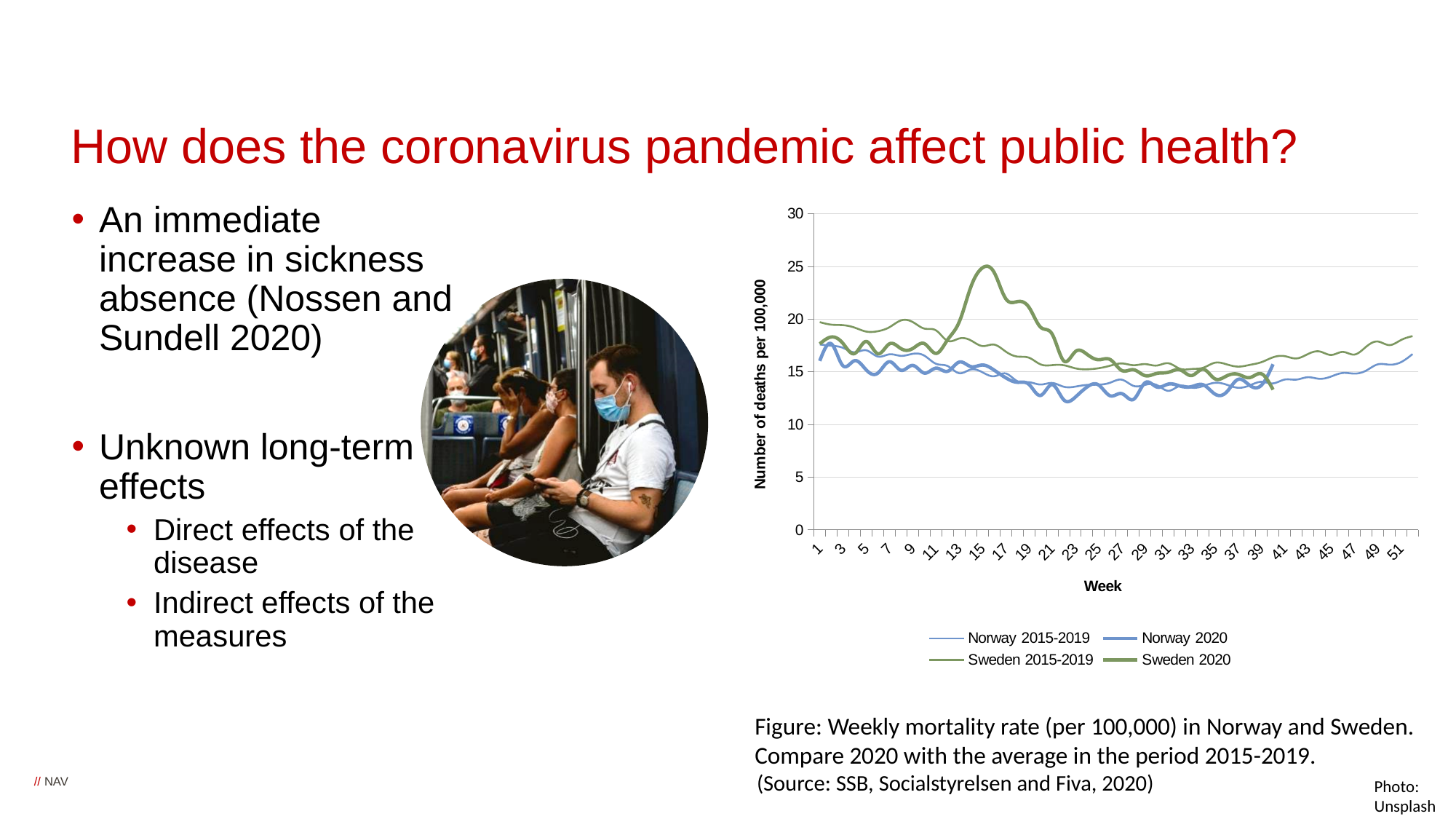
Which series reaches the lowest value on the chart? Norway 2020 At week 15, which series has the larger value: Sweden 2020 or Norway 2020? Sweden 2020 How many series does the chart's legend list? 4 Is the value for Norway 2020 at week 23 greater or less than 15? less Does the Sweden 2020 series rise or fall between week 16 and week 24? Fall What kind of chart is shown on the slide? Line chart What is the title of the chart's vertical axis? Number of deaths per 100,000 What is the label of the chart's horizontal axis? Week Which series reaches the highest value on the chart? Sweden 2020 Is the value for Sweden 2015-2019 at week 51 greater or less than 20? less Is the peak value for Sweden 2020 around week 15 greater or less than 20? greater Does the Norway 2015-2019 series rise or fall between week 41 and week 52? Rise